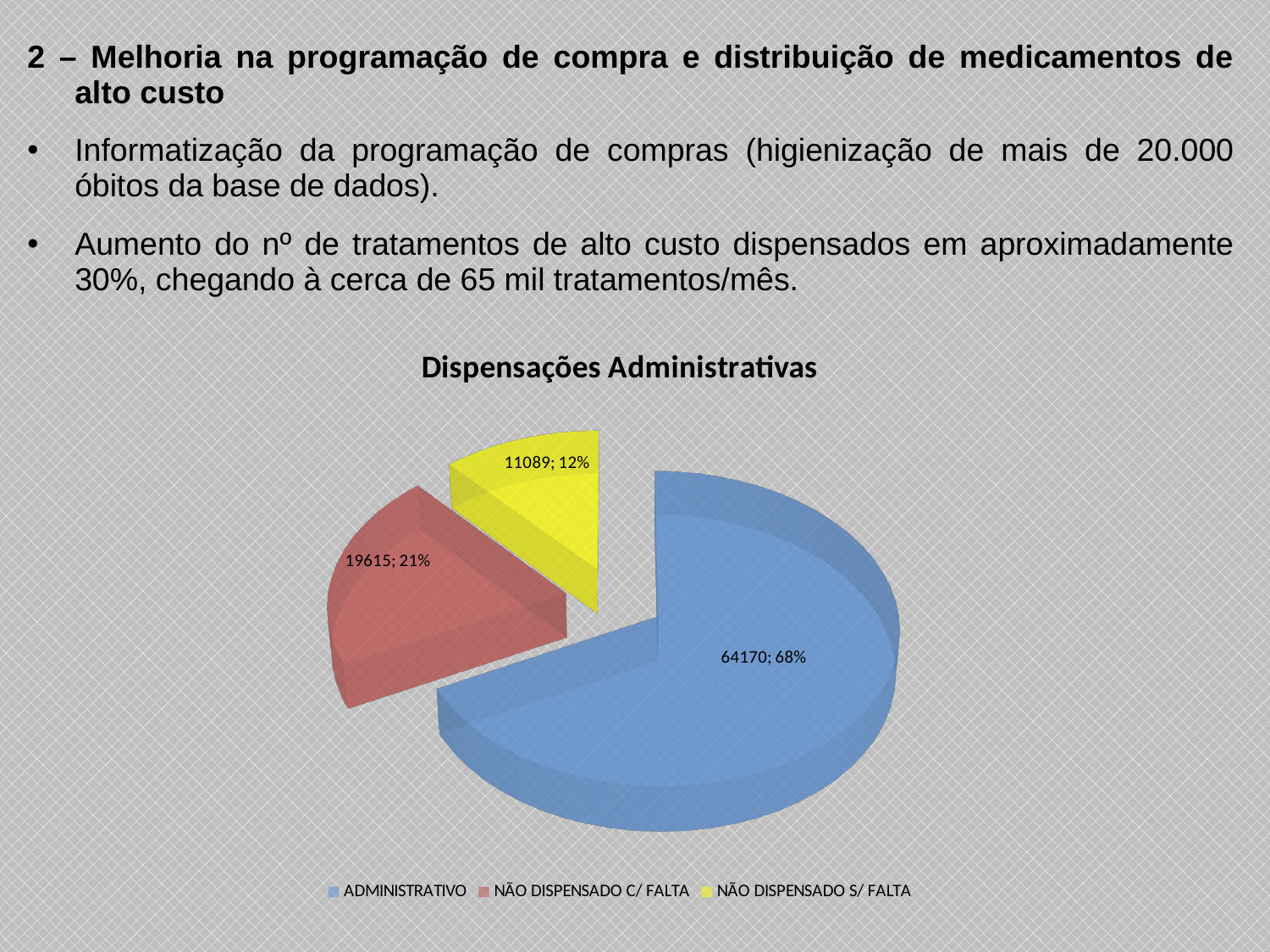
What is the value for NÃO DISPENSADO S/ FALTA? 11089 What type of chart is shown on the slide? Pie chart How many entries does the legend list? 3 Which category has the smallest slice? NÃO DISPENSADO S/ FALTA What is the title of the chart? Dispensações Administrativas What is the difference between the values for NÃO DISPENSADO C/ FALTA and NÃO DISPENSADO S/ FALTA? 8526 Which category has the largest slice? ADMINISTRATIVO What share of the pie does ADMINISTRATIVO represent? 68% What share of the pie does NÃO DISPENSADO S/ FALTA represent? 12% What is the value for ADMINISTRATIVO? 64170 What is the value for NÃO DISPENSADO C/ FALTA? 19615 How many slices does the pie chart have? 3